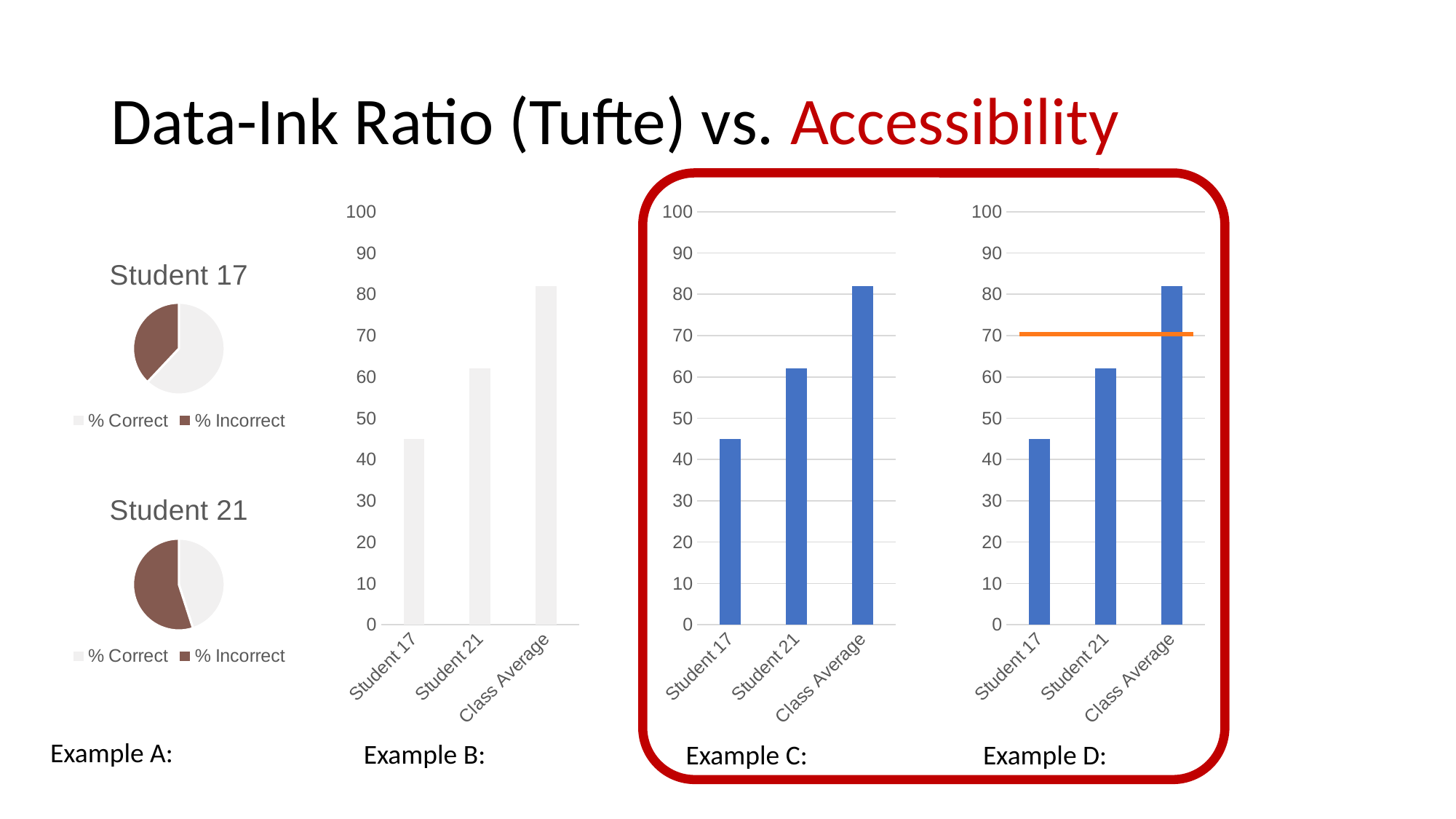
What is the title of the top pie chart in Example A? Student 17 In Example C, which category has the highest bar? Class Average What kind of chart is used for Student 17 in Example A? pie chart In Example D, do the bar values rise or fall from Student 17 to Class Average? rise How many categories are shown on the x axis of Example B? 3 How many series does the legend list for the Student 21 pie chart in Example A? 2 In Example D, is the value for Class Average greater or less than 80? greater In Example B, is the value for Student 17 greater or less than 50? less In Example C, is the value for Student 21 greater or less than 60? greater In Example D, which is larger, the value for Student 21 or the value for Student 17? Student 21 What kind of chart is Example C? bar chart In Example C, which category has the lowest bar? Student 17